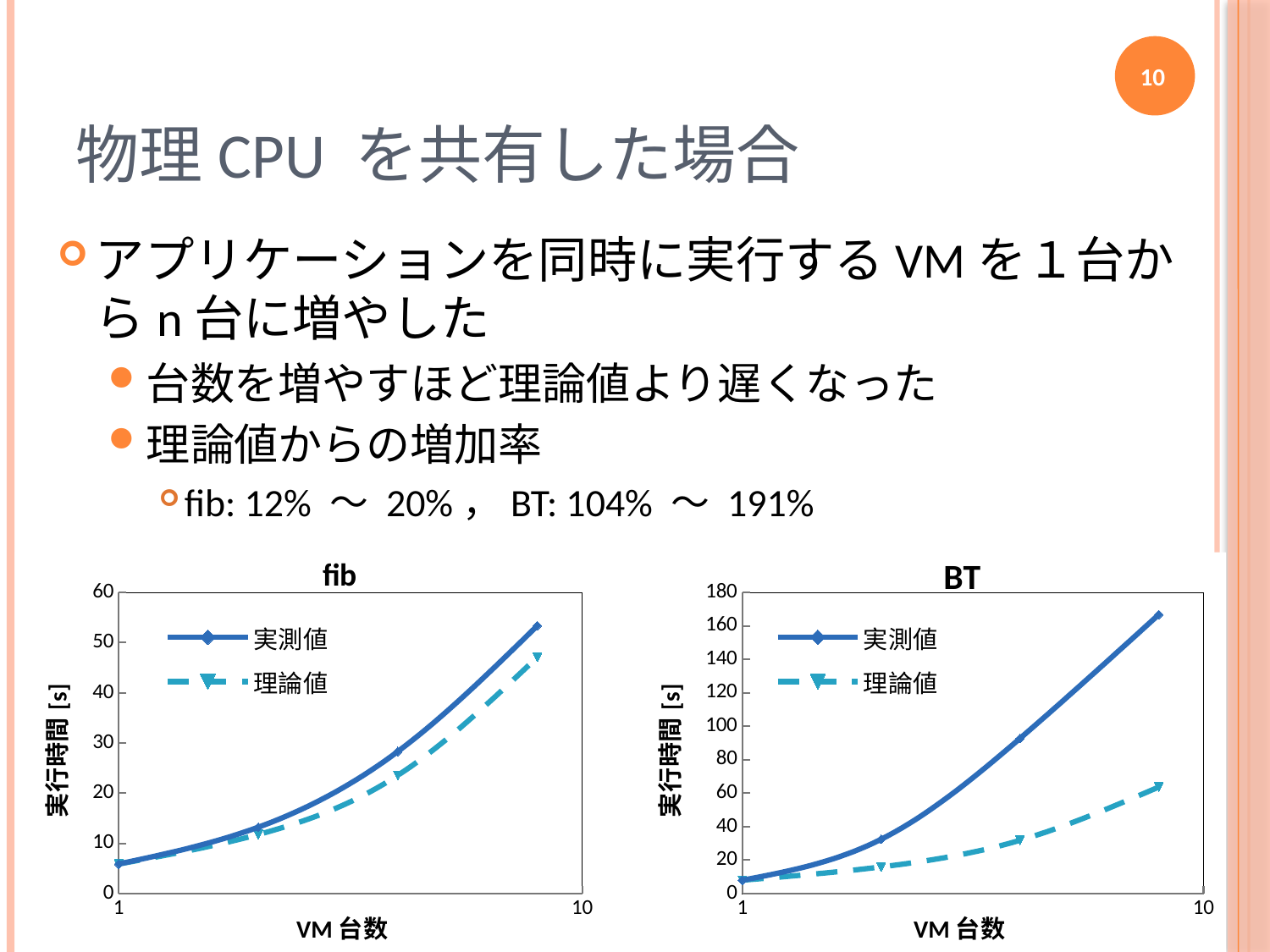
How many data points are plotted for the 実測値 series in the fib chart? 4 In the BT chart, is the 実測値 value at 8 VMs greater or less than 140? greater In the BT chart, at 8 VMs, which series has the larger value, 実測値 or 理論値? 実測値 How many series does the legend of the BT chart list? 2 In the BT chart, is the 理論値 value at 8 VMs greater or less than 80? less In the BT chart, does the 実測値 series rise or fall as VM 台数 increases? rise What is the label of the y axis on the BT chart? 実行時間 [s] What kind of chart is the fib chart? line chart In the fib chart, does the 理論値 series rise or fall as VM 台数 increases? rise What kind of chart is the BT chart? line chart How many series does the legend of the fib chart list? 2 In the fib chart, is the 実測値 value at 8 VMs greater or less than 50? greater